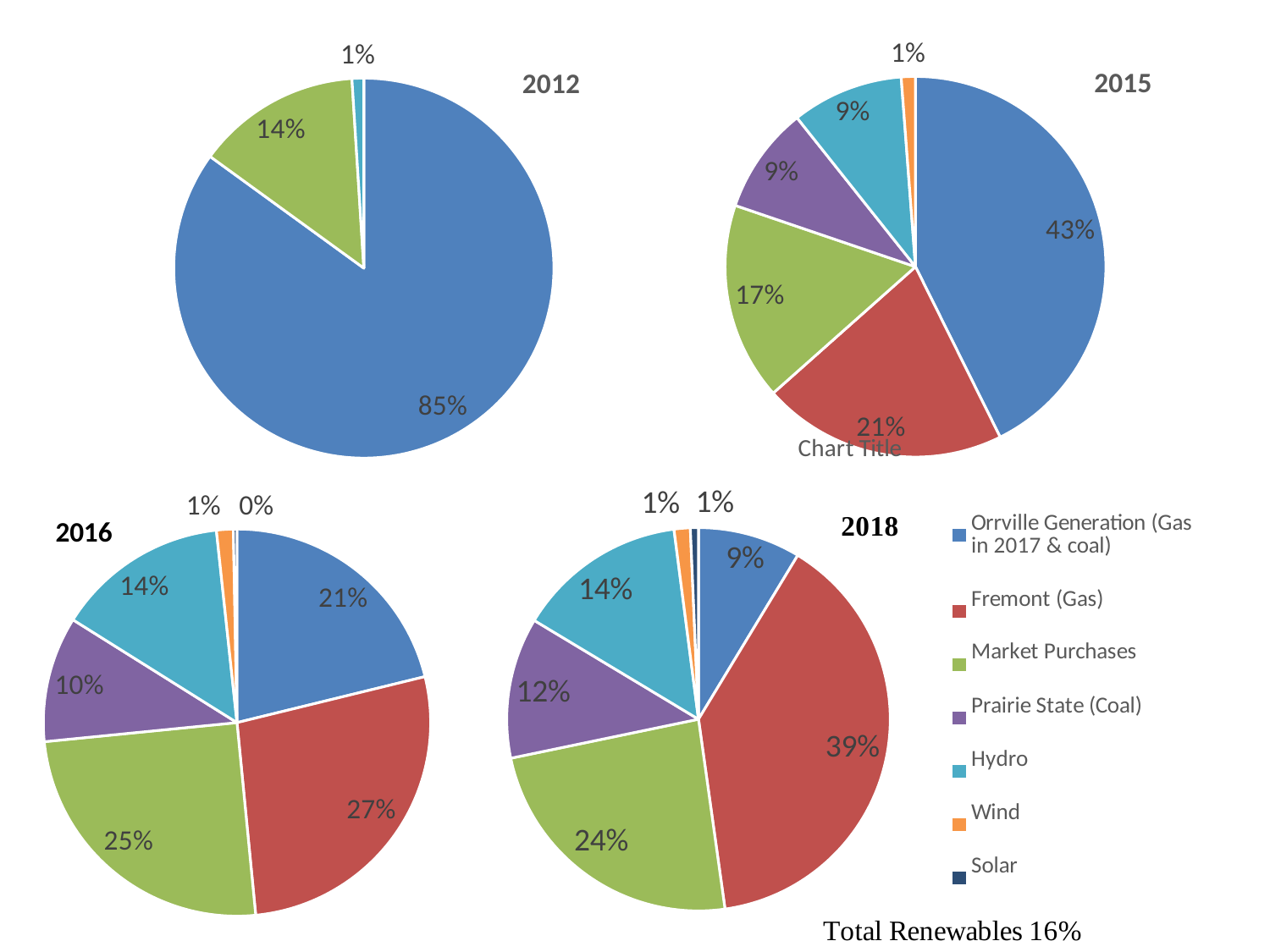
In the 2018 pie chart, what share is shown for Fremont (Gas)? 39% What type of chart is used for the 2015 data? Pie chart In the 2016 pie chart, what share is shown for Hydro? 14% In the 2012 pie chart, what share is shown for Orrville Generation (Gas in 2017 & coal)? 85% How many pie charts are on the slide? 4 How many categories does the legend list? 7 In the 2018 pie chart, what is the difference between the Fremont (Gas) share and the Market Purchases share? 15% In the 2015 pie chart, which category has the largest slice? Orrville Generation (Gas in 2017 & coal) In the 2015 pie chart, what share is shown for Fremont (Gas)? 21% In the 2016 pie chart, which is larger, Fremont (Gas) or Market Purchases? Fremont (Gas) In the 2012 pie chart, what share is shown for Market Purchases? 14% In the 2018 pie chart, what share is shown for Prairie State (Coal)? 12%